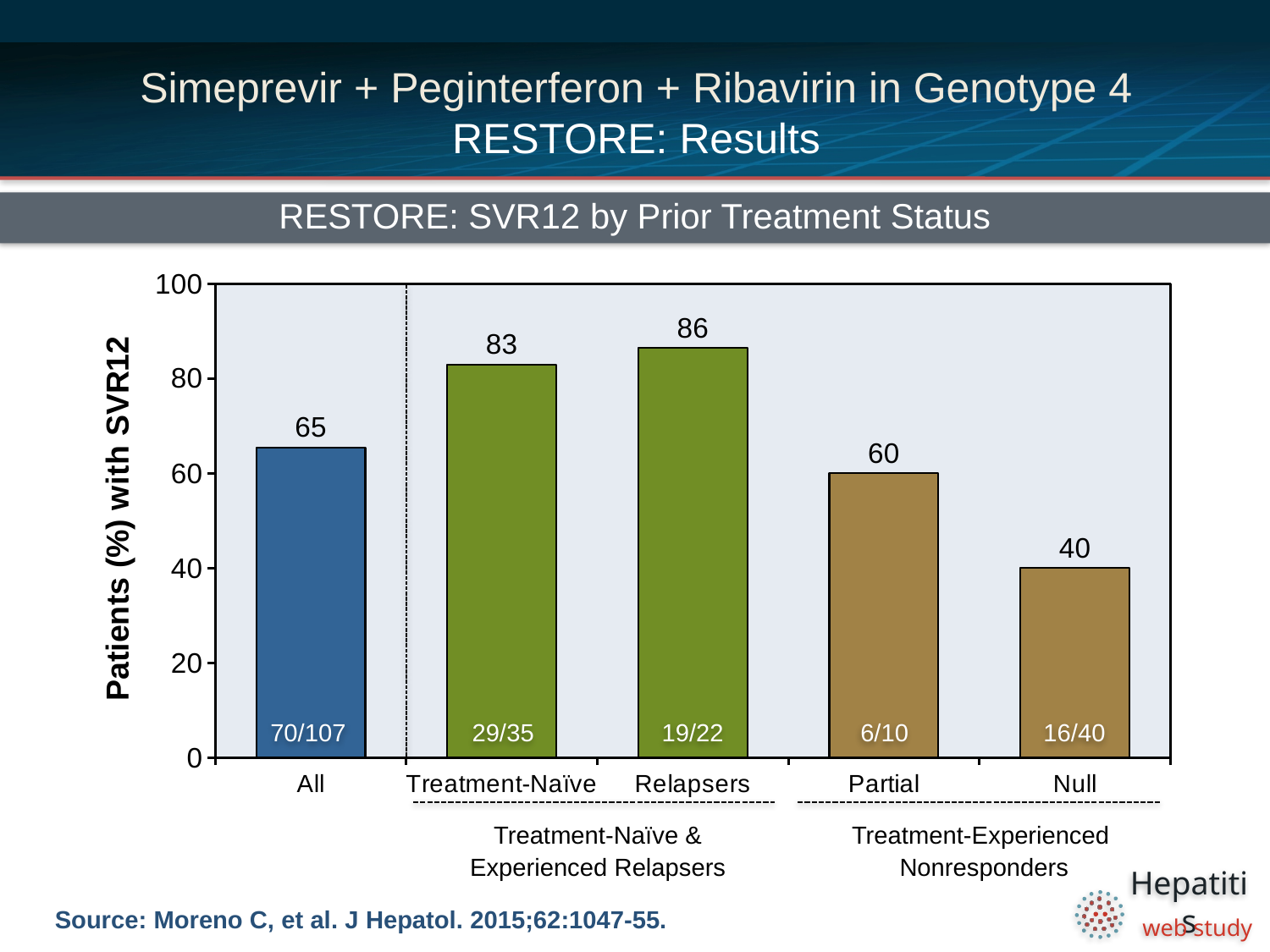
Which has a higher SVR12 rate, Partial or Null? Partial Which category has the highest SVR12 rate? Relapsers How many categories are shown on the x axis? 5 What is the title of the chart? RESTORE: SVR12 by Prior Treatment Status What is the SVR12 rate (%) for Relapsers? 86 What is the SVR12 rate (%) for the All group? 65 What type of chart is shown? bar chart What fraction of patients is shown inside the Treatment-Naïve bar? 29/35 Which category has the lowest SVR12 rate? Null What is the SVR12 rate (%) for the Null group? 40 What is the difference in SVR12 rate between Treatment-Naïve and Partial? 23 Is the SVR12 rate for Relapsers greater or less than 80? greater